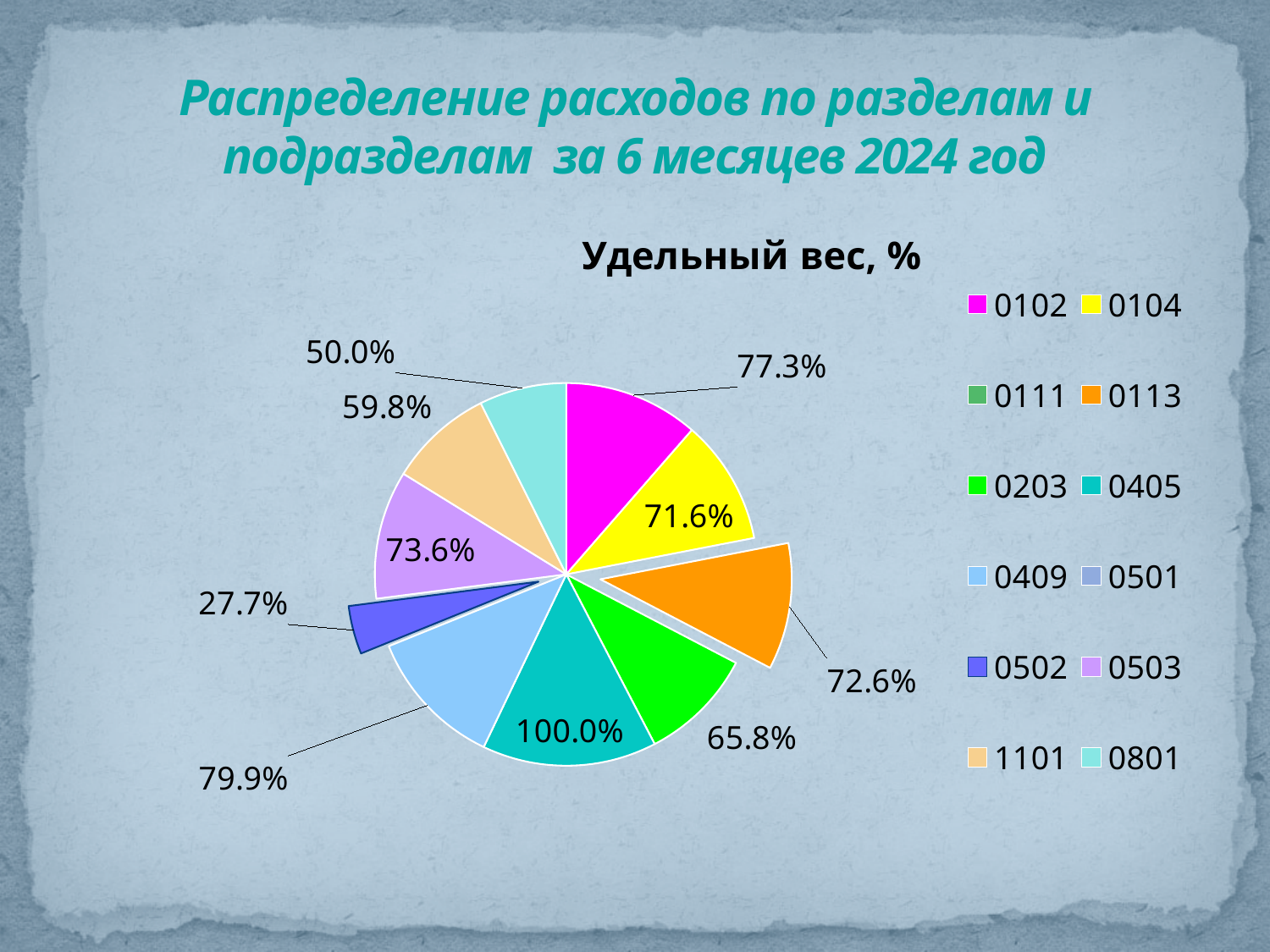
What value is shown for category 0113? 72.6% What value is shown for category 0405? 100.0% What type of chart is shown on the slide? pie chart How many entries does the legend list? 12 What is the difference between the values for 0405 and 0502? 72.3% Which has the larger value, 0409 or 0503? 0409 What value is shown for category 0102? 77.3% What is the title of the chart? Удельный вес, % Which category has the highest value? 0405 What value is shown for category 0502? 27.7% What value is shown for category 0801? 50.0%